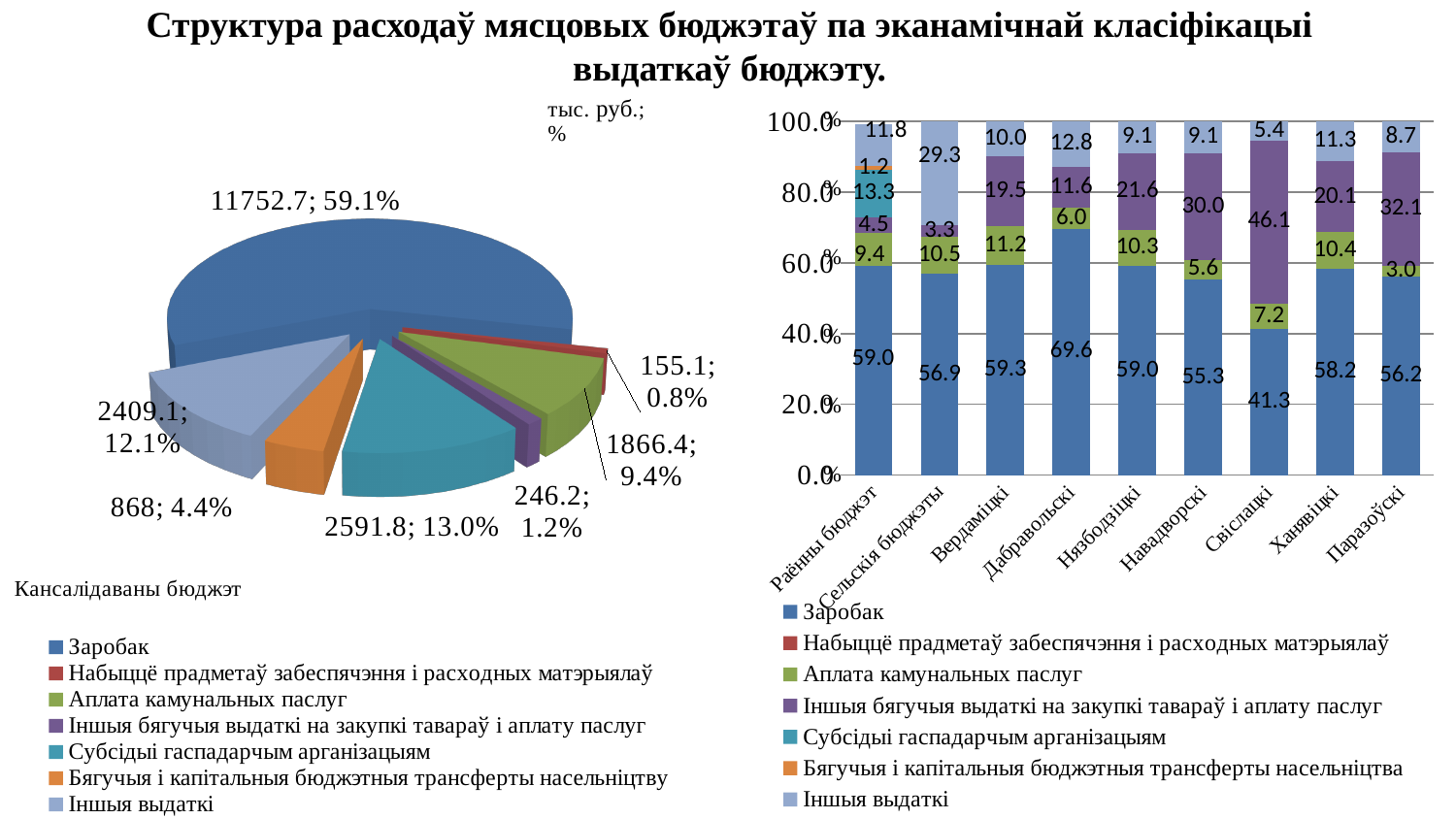
What type of chart is the left chart (Кансалідаваны бюджэт)? pie chart How many series does the legend of the right stacked bar chart list? 7 In the left pie chart, what value and share are shown for the largest slice (Заробак)? 11752.7; 59.1% How many categories are shown on the x axis of the right stacked bar chart? 9 In the right stacked bar chart, which is larger: the Іншыя бягучыя выдаткі value for Свіслацкі or for Паразоўскі? Свіслацкі What type of chart is the right chart? stacked bar chart In the left pie chart, which category has the smallest share? Набыццё прадметаў забеспячэння і расходных матэрыялаў In the right stacked bar chart, what is the Заробак value for Дабравольскі? 69.6 In the left pie chart, what is the value shown for Іншыя выдаткі? 2409.1 In the left pie chart, what share does the Субсідыі гаспадарчым арганізацыям slice have? 13.0% In the right stacked bar chart, what is the difference between the Заробак values for Дабравольскі and Свіслацкі? 28.3 In the right stacked bar chart, which category has the lowest Заробак value? Свіслацкі